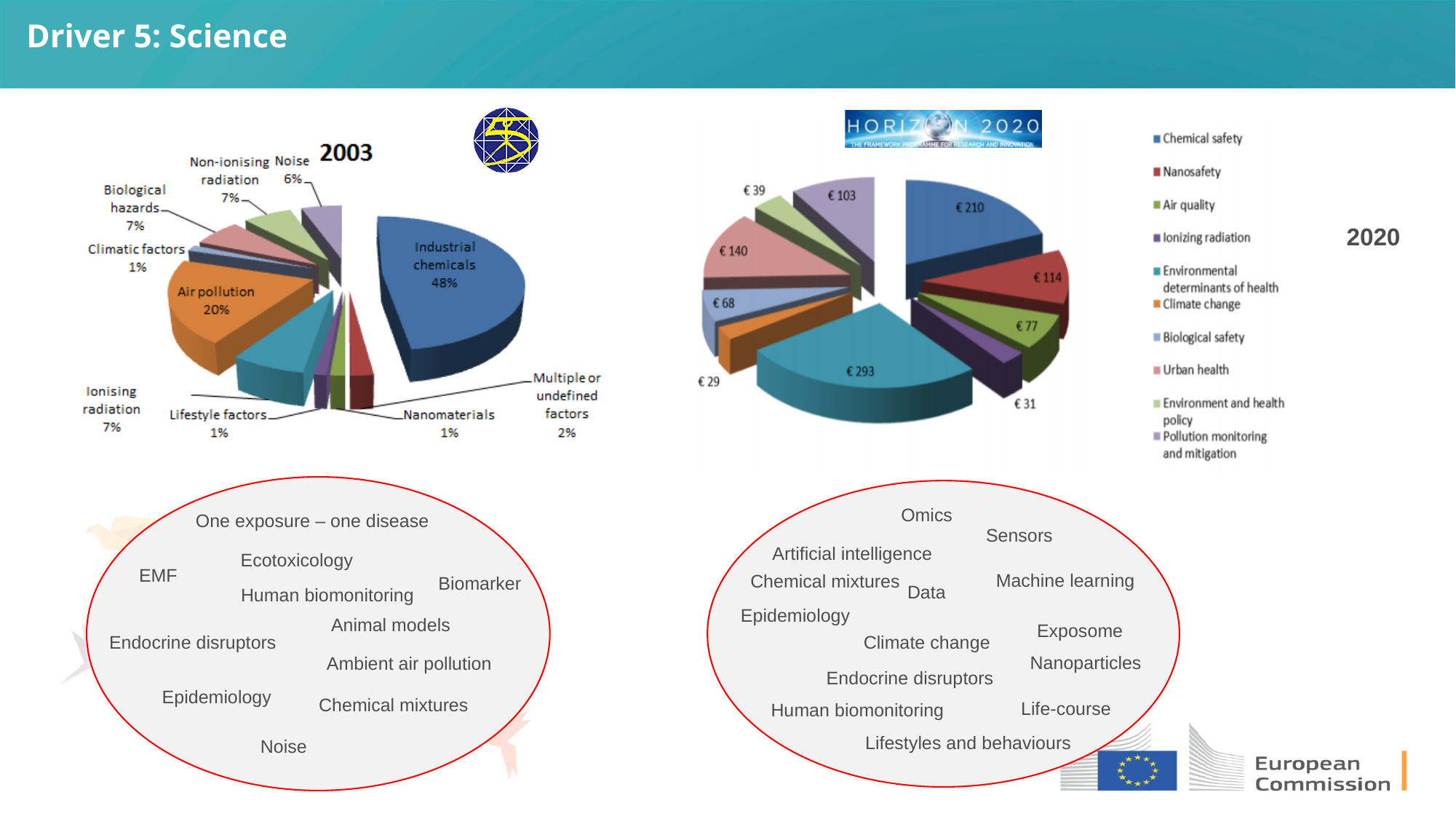
In the 2020 pie chart, what is the value for Environmental determinants of health? € 293 In the 2020 pie chart, which category has the smallest value? Climate change In the 2020 pie chart, what is the difference between Urban health and Nanosafety? € 26 In the 2003 pie chart, which is larger, Noise or Non-ionising radiation? Non-ionising radiation In the 2020 pie chart, what is the value for Chemical safety? € 210 In the 2003 pie chart, how many categories are shown? 10 What type of chart is used for the 2003 data? Pie chart How many entries does the legend of the 2020 pie chart list? 10 In the 2003 pie chart, what percentage is attributed to Industrial chemicals? 48% In the 2003 pie chart, what percentage is attributed to Air pollution? 20% In the 2003 pie chart, what is the difference in percentage points between Industrial chemicals and Air pollution? 28 In the 2003 pie chart, which category has the largest share? Industrial chemicals